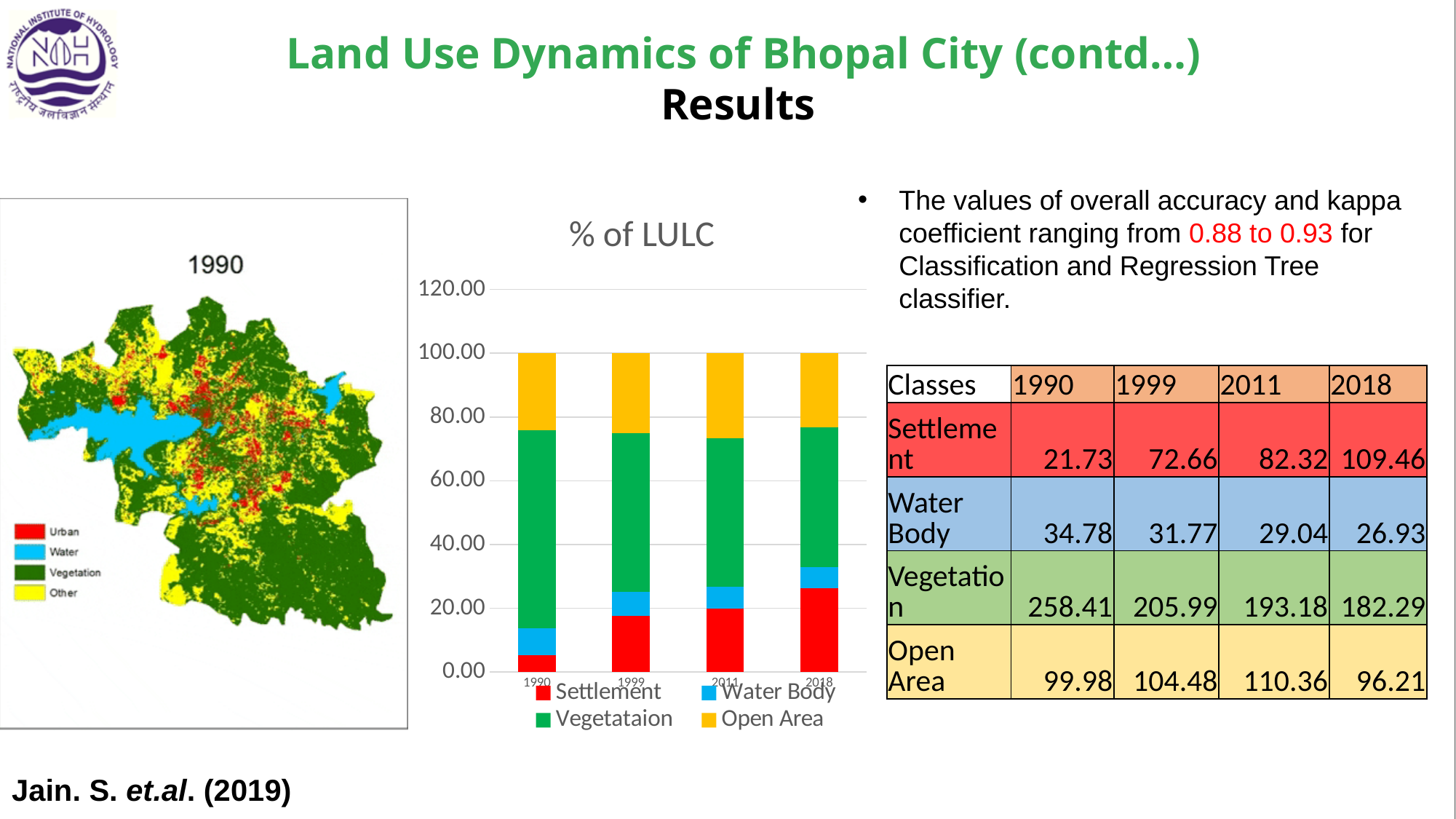
What is the title of the stacked bar chart? % of LULC In the '% of LULC' chart, which year has the largest Settlement segment? 2018 In the '% of LULC' chart, what is the total height of the stacked bar for 1990? 100.00 In the '% of LULC' chart, does the Vegetataion share rise or fall from 1990 to 2018? fall How many series does the legend of the '% of LULC' chart list? 4 In the '% of LULC' chart, which year has the smallest Settlement segment? 1990 In the '% of LULC' chart, is the Settlement value for 2018 greater or less than 20.00? greater In the '% of LULC' chart, does the Settlement share rise or fall from 1990 to 2018? rise How many years (categories) are shown on the x axis of the '% of LULC' chart? 4 In the '% of LULC' chart, which colour represents Settlement? red In the '% of LULC' chart, is the Settlement value for 1990 greater or less than 20.00? less What kind of chart is the '% of LULC' chart? stacked bar chart